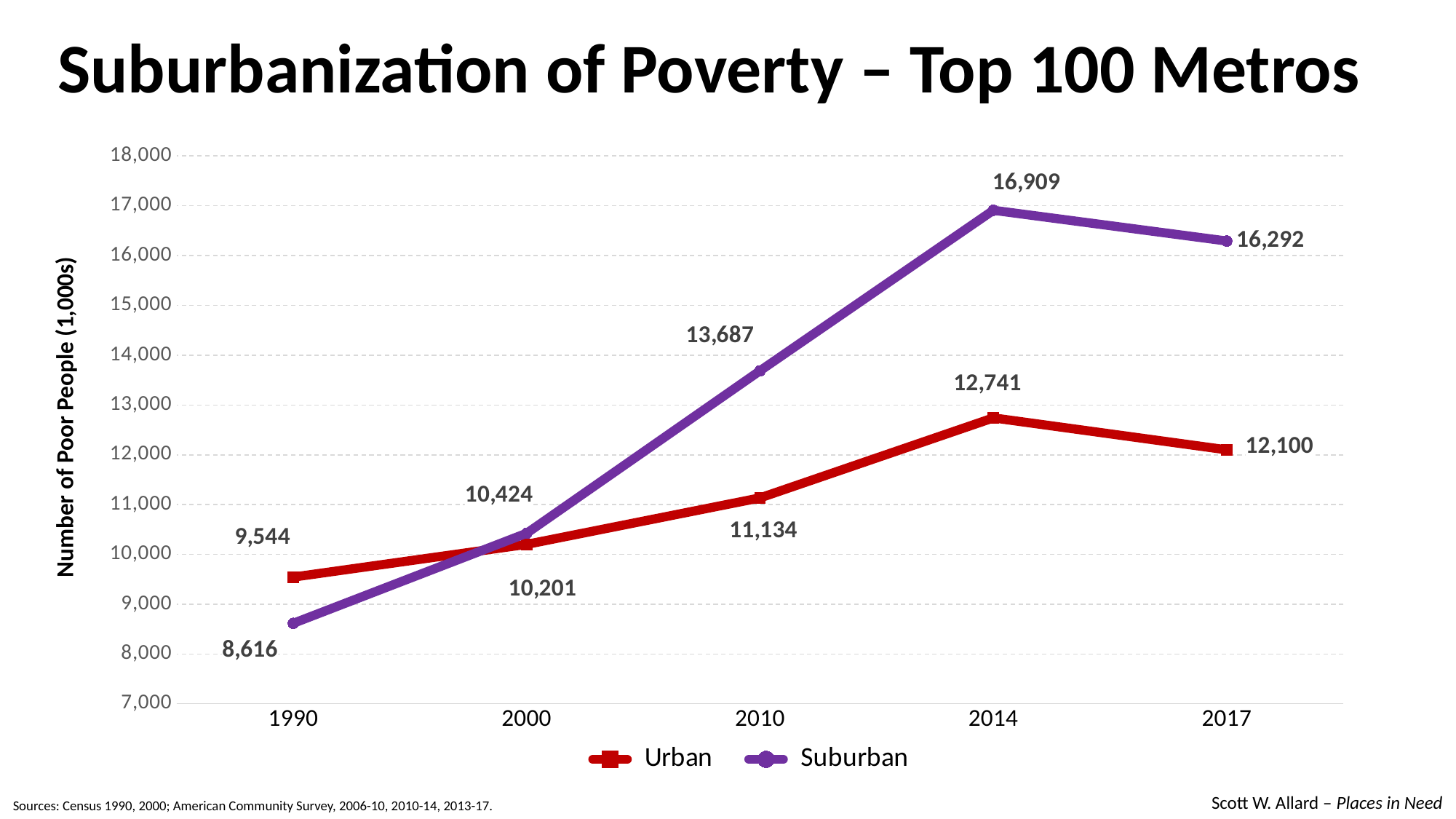
How many series does the legend list? 2 Which series has the larger value in 1990, Urban or Suburban? Urban What is the Suburban value for 2014? 16,909 By how much did the Urban value fall from 2014 to 2017? 641 In which year does the Suburban series reach its highest value? 2014 In which year is the Suburban series at its lowest value? 1990 What kind of chart is shown on the slide? Line chart How many years are shown on the x axis? 5 What is the difference between the Suburban and Urban values in 2014? 4,168 What is the Urban value for 1990? 9,544 What is the Urban value for 2017? 12,100 What is the Suburban value for 2010? 13,687